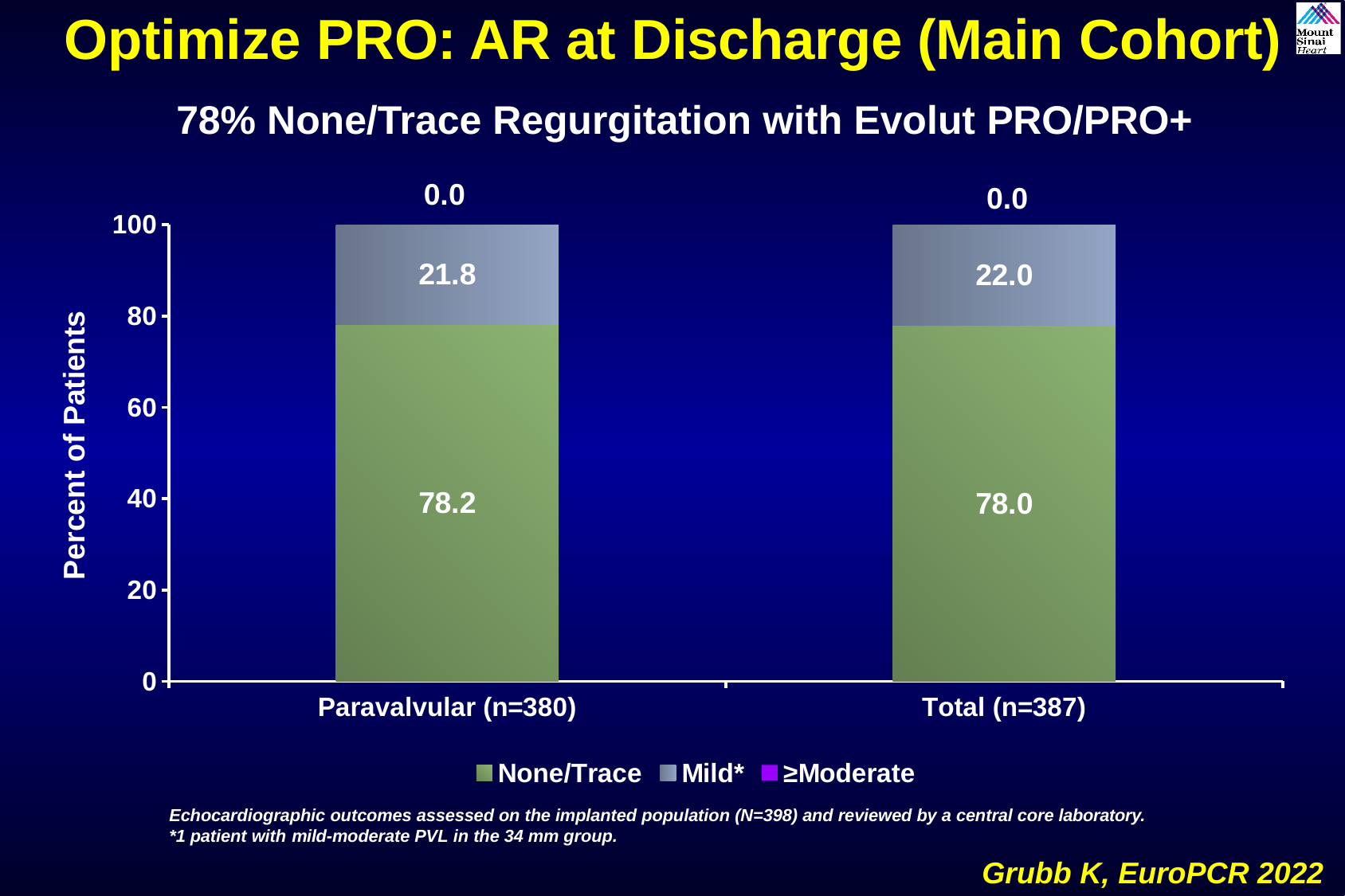
What is the None/Trace value for Total (n=387)? 78.0 What is the Mild* value for Total (n=387)? 22.0 Is the None/Trace value for Paravalvular (n=380) greater or less than 60? greater What kind of chart is shown on the slide? Stacked bar chart How many series does the legend list? 3 What is the difference between the None/Trace values for Paravalvular (n=380) and Total (n=387)? 0.2 What is the label of the y axis? Percent of Patients What is the None/Trace value for Paravalvular (n=380)? 78.2 What is the ≥Moderate value for Paravalvular (n=380)? 0.0 Which series has the larger value for Total (n=387), None/Trace or Mild*? None/Trace How many categories are shown on the x axis? 2 What is the total of the stacked bar for Paravalvular (n=380)? 100.0